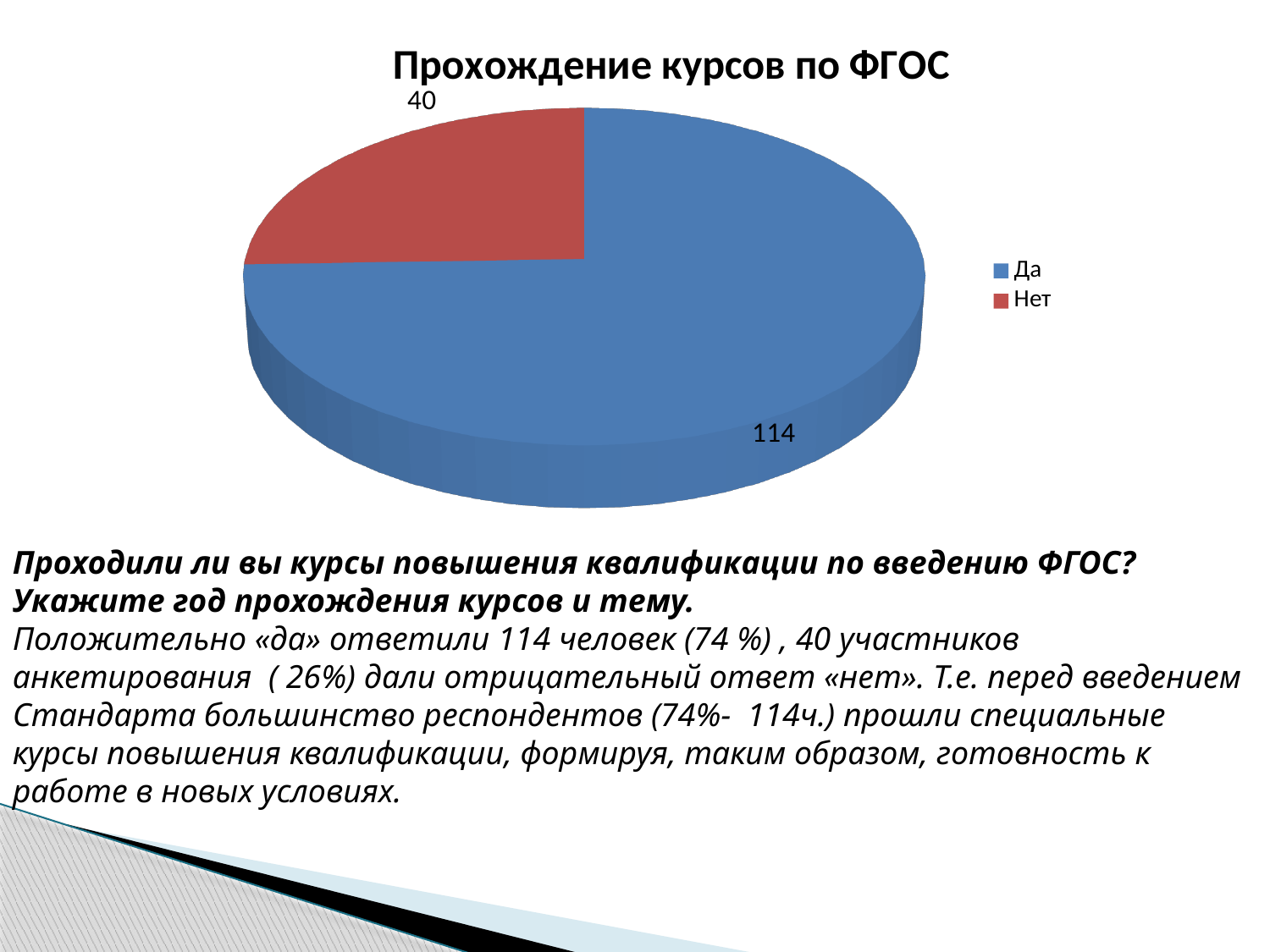
What is the total of all slices in the pie chart? 154 What type of chart is shown on the slide? pie chart What share of the pie does the "Да" slice represent, to the nearest percent? 74% How many slices does the pie chart have? 2 Which category has the largest slice? Да Which is larger, the value for "Да" or the value for "Нет"? Да What is the difference between the "Да" and "Нет" values? 74 What is the value for the "Нет" slice? 40 What is the value for the "Да" slice? 114 What is the title of the chart? Прохождение курсов по ФГОС Which category has the smallest slice? Нет How many entries does the legend list? 2